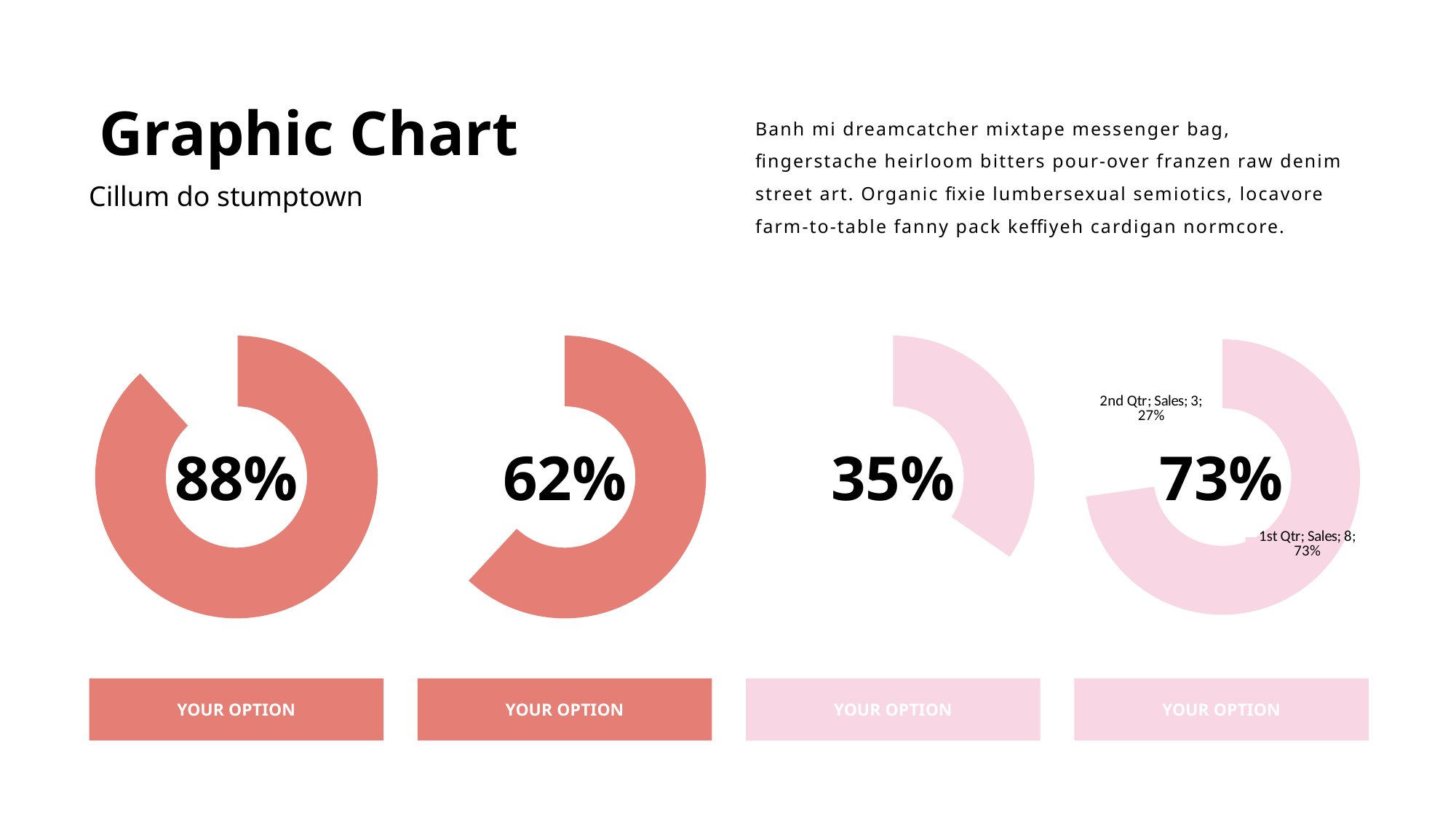
In the rightmost doughnut chart, what is the Sales value for 1st Qtr? 8 In the rightmost doughnut chart, what is the Sales value for 2nd Qtr? 3 Which of the four doughnut charts shows the highest percentage? The leftmost chart (88%) In the rightmost doughnut chart, what is the difference between the 1st Qtr and 2nd Qtr Sales values? 5 In the rightmost doughnut chart, what share of the doughnut does 2nd Qtr take? 27% What percentage is shown in the centre of the second doughnut chart from the left? 62% Which of the four doughnut charts shows the lowest percentage? The third chart from the left (35%) What kind of chart is used for each of the four charts on the slide? Doughnut chart What percentage is shown in the centre of the leftmost doughnut chart? 88% What percentage is shown in the centre of the rightmost doughnut chart? 73% What percentage is shown in the centre of the third doughnut chart from the left? 35% In the rightmost doughnut chart, which quarter has the larger Sales value, 1st Qtr or 2nd Qtr? 1st Qtr